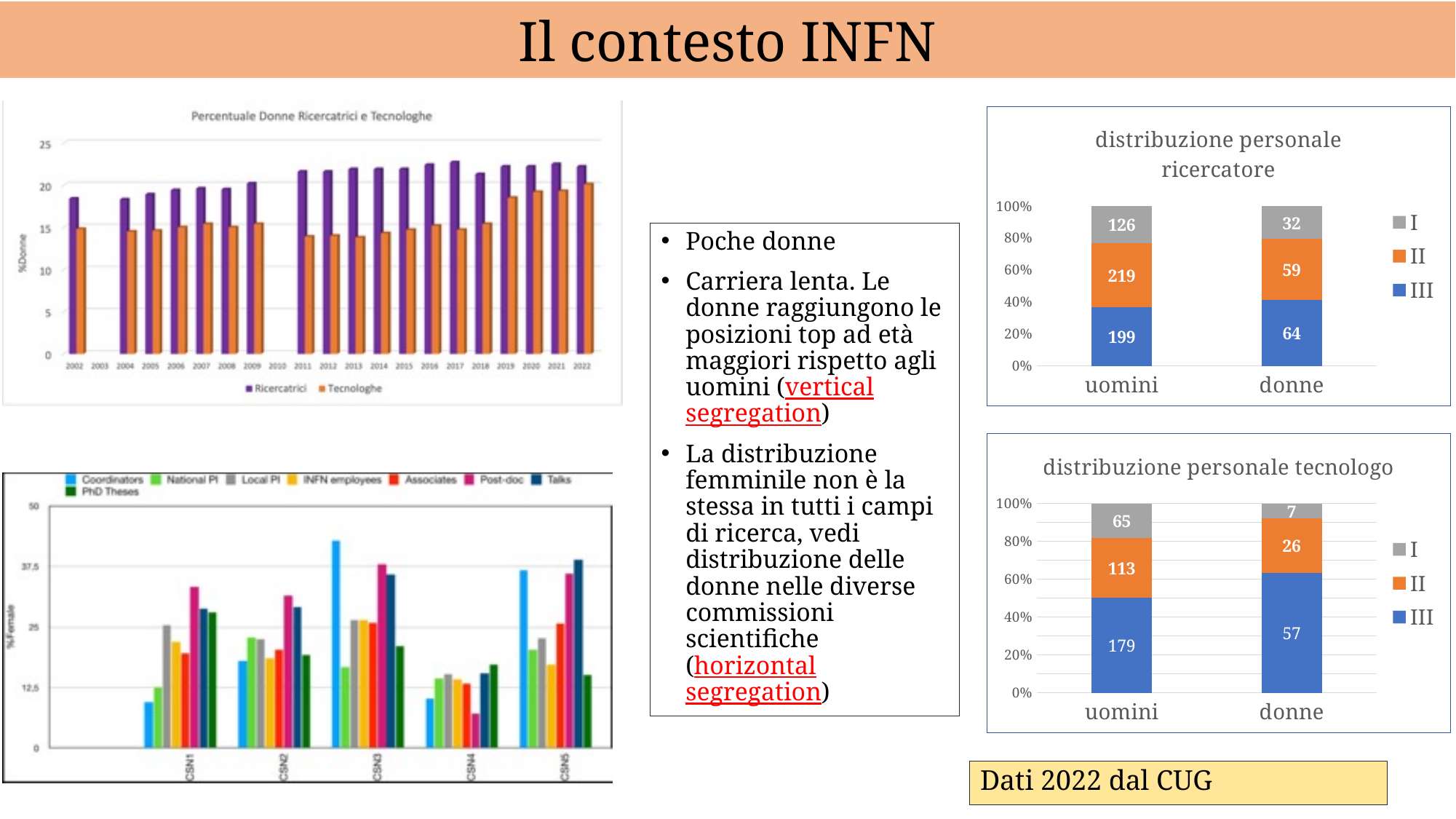
In the 'distribuzione personale ricercatore' chart, what is the difference between level III for uomini and level III for donne? 135 In the 'distribuzione personale tecnologo' chart, which level has the lowest value for donne? I In the 'distribuzione personale tecnologo' chart, what is the value for level III for donne? 57 In the 'distribuzione personale ricercatore' chart, what is the value for level I for donne? 32 What kind of chart is the bottom-left chart showing CSN1 to CSN5? bar chart In the 'distribuzione personale ricercatore' chart, what is the value for level II for uomini? 219 In the 'distribuzione personale tecnologo' chart, what is the total of the stacked bar for uomini? 357 In the 'Percentuale Donne Ricercatrici e Tecnologhe' chart, is the value for Ricercatrici in 2022 greater or less than 20? greater How many series does the legend of the 'distribuzione personale tecnologo' chart list? 3 In the 'distribuzione personale ricercatore' chart, what is the total of the stacked bar for donne? 155 How many series does the legend of the 'Percentuale Donne Ricercatrici e Tecnologhe' chart list? 2 In the 'distribuzione personale tecnologo' chart, which is larger for uomini: level II or level I? level II